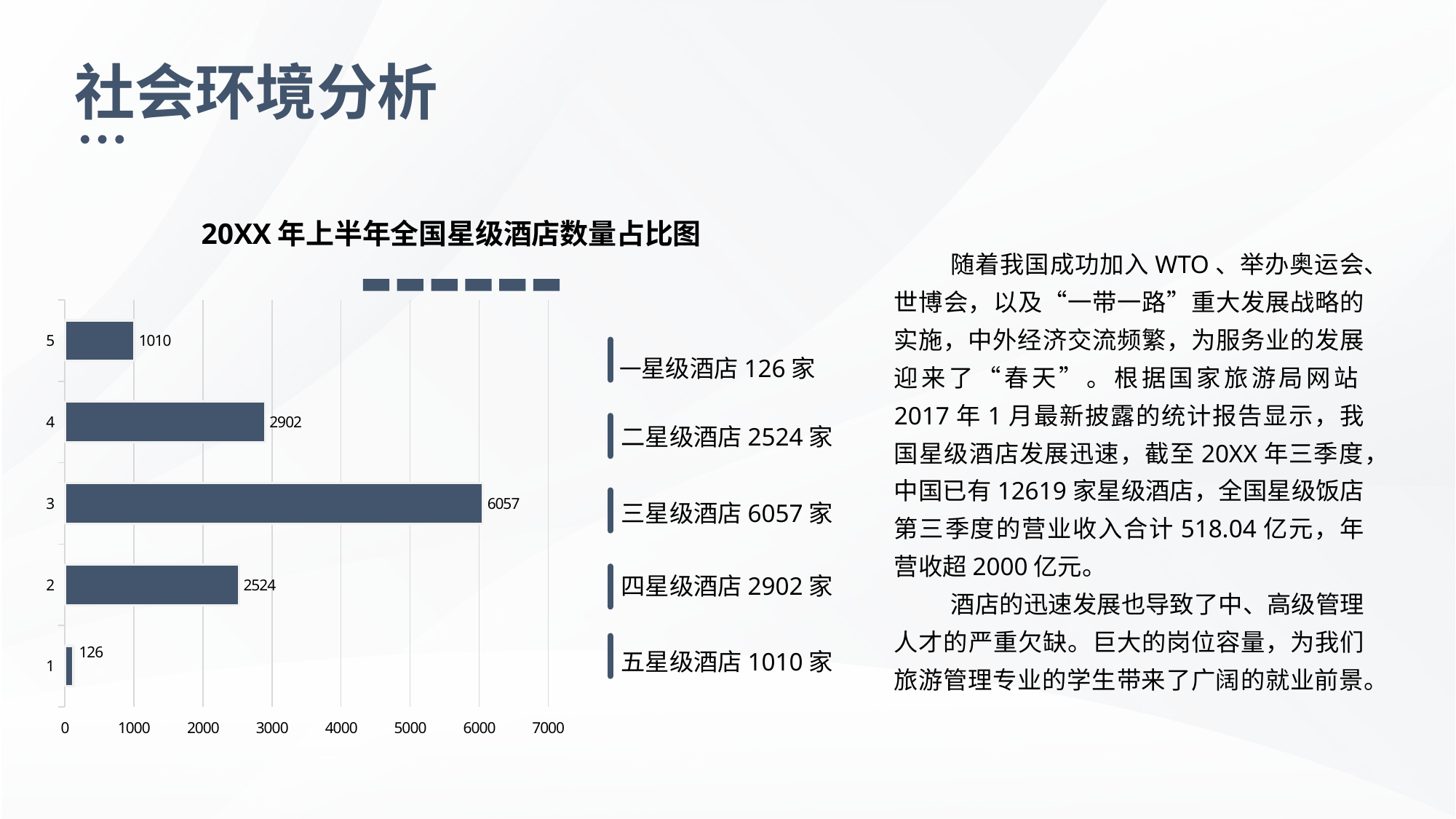
What kind of chart is shown on the slide? bar chart What is the difference between the values for category 2 and category 5? 1514 What is the title of the chart? 20XX 年上半年全国星级酒店数量占比图 Which is larger, the value for category 4 or the value for category 2? category 4 What is the difference between the values for category 3 and category 4? 3155 Is the value for category 4 greater or less than 3000? less Which category has the lowest value? 1 What is the value for category 5? 1010 What is the value for category 3? 6057 How many categories are shown in the chart? 5 Which category has the highest value? 3 What is the value for category 1? 126